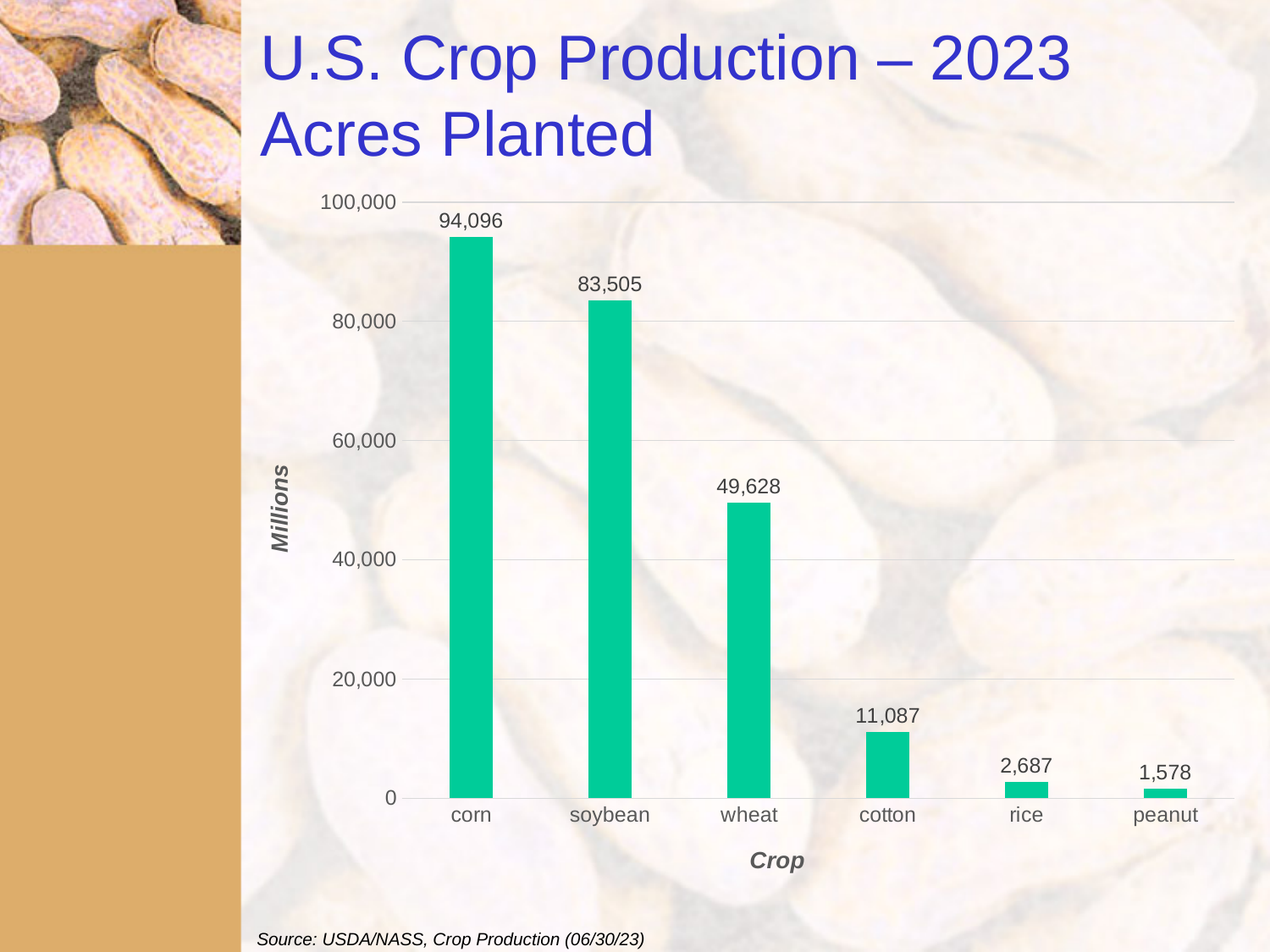
What kind of chart is shown on the slide? bar chart What is the difference between the values for cotton and rice? 8,400 Which is larger, the value for soybean or the value for wheat? soybean Which crop has the highest value? corn What is the label of the y axis? Millions How many crops are shown on the chart? 6 What is the value for wheat? 49,628 Is the value for wheat greater or less than 40,000? greater Which crop has the lowest value? peanut What is the value for corn? 94,096 What is the difference between the values for corn and soybean? 10,591 What is the value for peanut? 1,578